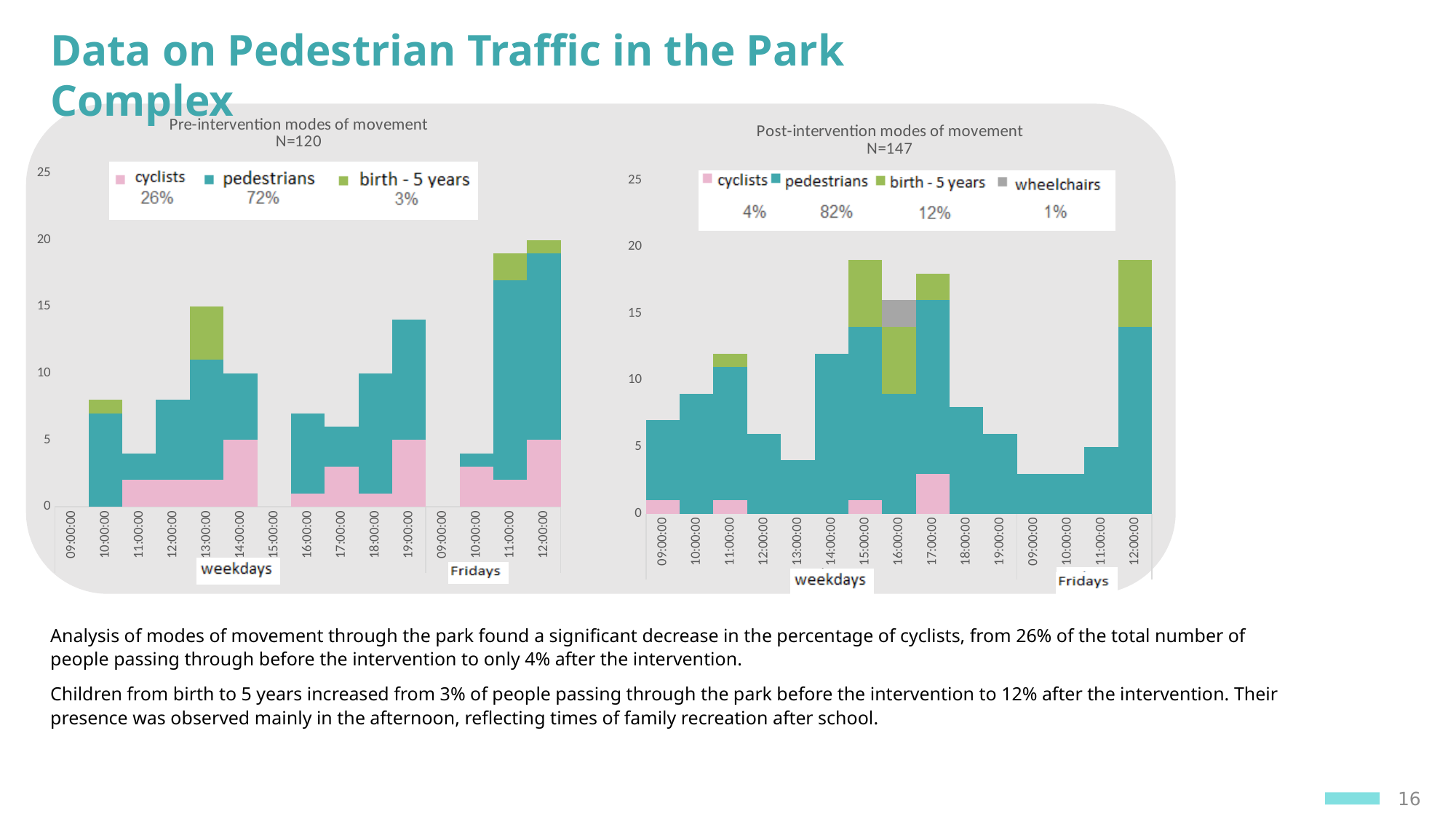
In the 'Post-intervention modes of movement' chart, what percentage is shown in the legend for wheelchairs? 1% How many series does the legend of the 'Pre-intervention modes of movement' chart list? 3 What kind of chart is the 'Pre-intervention modes of movement' chart? Stacked bar chart What is the difference between the pedestrians percentage in the 'Post-intervention' legend (82%) and in the 'Pre-intervention' legend (72%)? 10 percentage points How many time slots are shown on the x axis of the 'Post-intervention modes of movement' chart? 15 In the 'Pre-intervention modes of movement' chart, which stacked bar is taller: weekdays 13:00:00 or weekdays 14:00:00? weekdays 13:00:00 In the 'Post-intervention modes of movement' chart, is the total for Fridays 10:00:00 greater or less than 5? less How many series does the legend of the 'Post-intervention modes of movement' chart list? 4 In the 'Pre-intervention modes of movement' chart, what percentage is shown in the legend for pedestrians? 72% In the 'Pre-intervention modes of movement' chart, which time slot has the tallest stacked bar? Fridays 12:00:00 In the 'Pre-intervention modes of movement' chart, is the total for weekdays 13:00:00 greater or less than 10? greater In the 'Post-intervention modes of movement' chart, what percentage is shown in the legend for cyclists? 4%